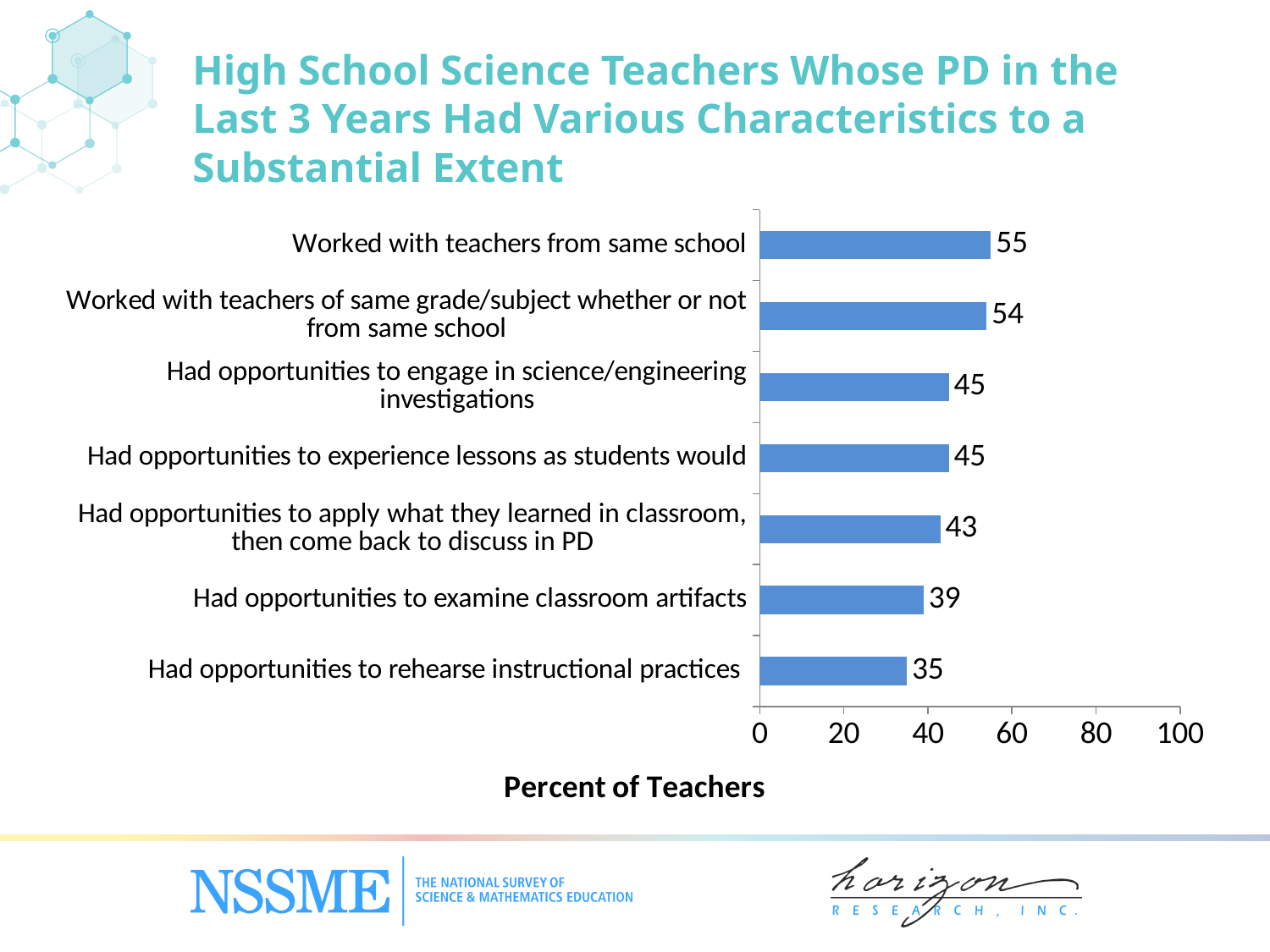
Is the value for 'Had opportunities to experience lessons as students would' greater or less than 40? greater How many categories are shown in the chart? 7 What is the difference between the values for 'Worked with teachers of same grade/subject whether or not from same school' and 'Had opportunities to engage in science/engineering investigations'? 9 Which category has the highest percent of teachers? Worked with teachers from same school What is the value for 'Had opportunities to examine classroom artifacts'? 39 What is the difference between the values for 'Worked with teachers from same school' and 'Had opportunities to rehearse instructional practices'? 20 What kind of chart is shown on the slide? Bar chart What is the label of the horizontal axis? Percent of Teachers Which category has the lowest percent of teachers? Had opportunities to rehearse instructional practices What is the value for 'Had opportunities to rehearse instructional practices'? 35 What percent of teachers worked with teachers from the same school? 55 Which is larger: the value for 'Had opportunities to examine classroom artifacts' or 'Had opportunities to apply what they learned in classroom, then come back to discuss in PD'? Had opportunities to apply what they learned in classroom, then come back to discuss in PD